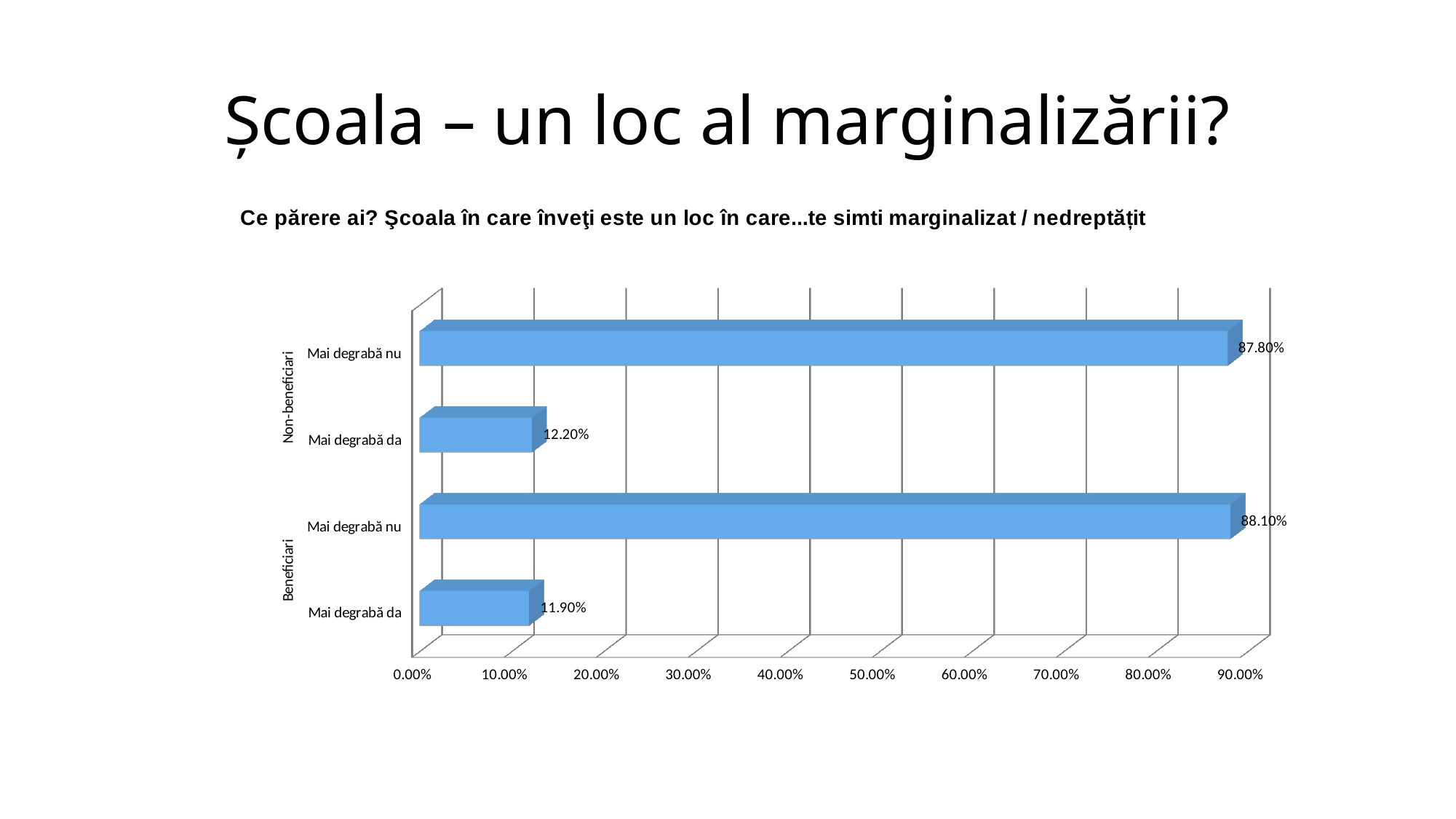
How many bars are plotted on the chart? 4 What is the value for 'Mai degrabă da' in the Beneficiari group? 11.90% What kind of chart is shown on the slide? Bar chart What is the value for 'Mai degrabă da' in the Non-beneficiari group? 12.20% What is the difference between 'Mai degrabă nu' for Beneficiari and 'Mai degrabă nu' for Non-beneficiari? 0.30% What is the value for 'Mai degrabă nu' in the Non-beneficiari group? 87.80% Which bar has the lowest value on the chart? Mai degrabă da (Beneficiari) What is the value for 'Mai degrabă nu' in the Beneficiari group? 88.10% What is the difference between 'Mai degrabă nu' and 'Mai degrabă da' in the Non-beneficiari group? 75.60% What is the highest value shown on the x axis of the chart? 90.00% Is the value for 'Mai degrabă da' in the Beneficiari group greater or less than 20.00%? less Which is larger: 'Mai degrabă da' for Non-beneficiari or 'Mai degrabă nu' for Non-beneficiari? Mai degrabă nu for Non-beneficiari